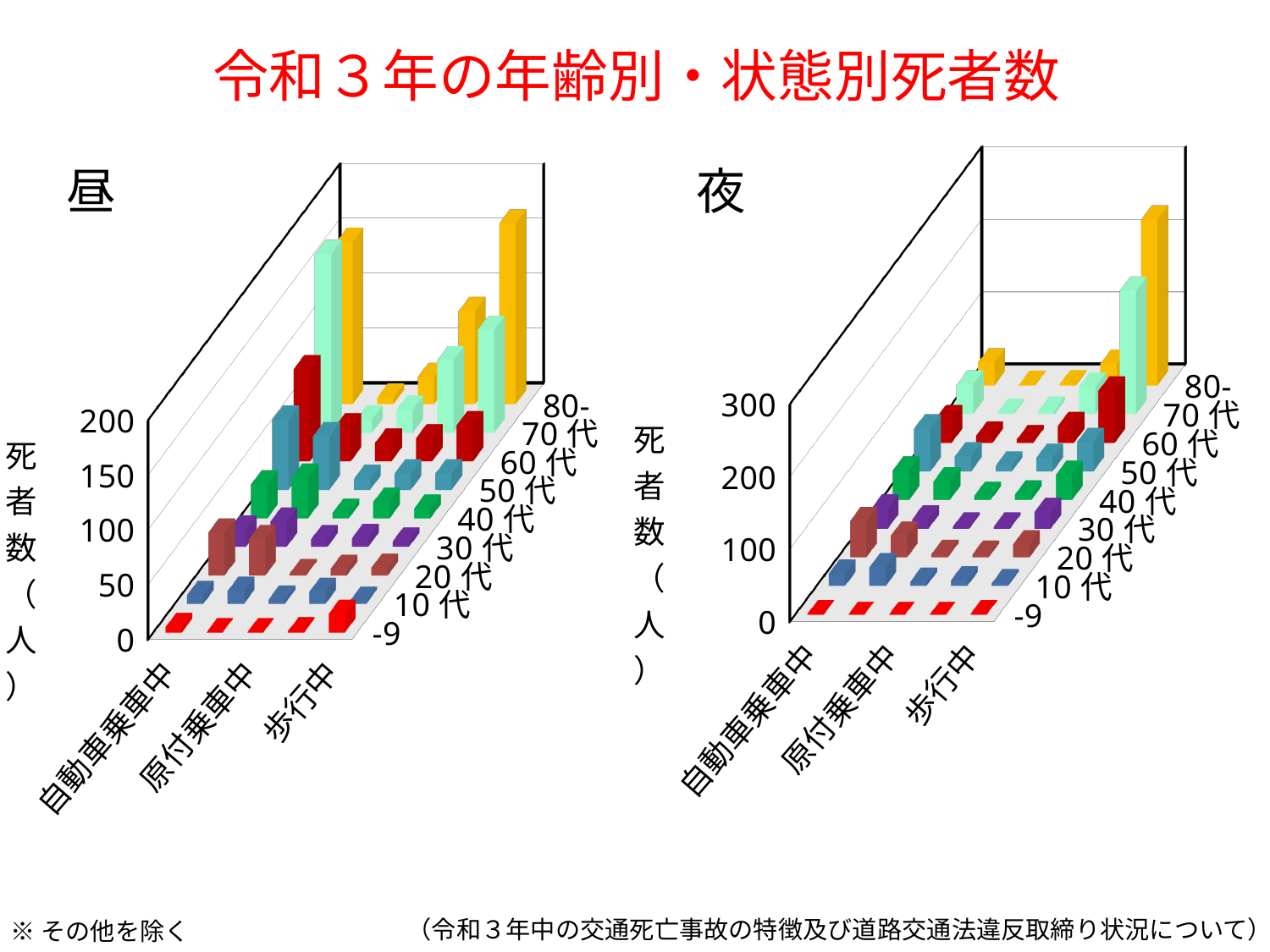
What is the highest value shown on the vertical axis of the 夜 chart? 300 What is the highest value shown on the vertical axis of the 昼 chart? 200 What is the title of the slide containing the two charts? 令和３年の年齢別・状態別死者数 In the 昼 chart, is the value for 歩行中 in the 80- age group greater or less than 100? greater How many age groups are shown along the depth axis of the 昼 chart? 9 In the 昼 chart, which is larger: the value for 歩行中 in the 80- age group or the value for 歩行中 in the 10代 age group? 歩行中 80- In the 夜 chart, is the value for 原付乗車中 in the 30代 age group greater or less than 100? less In the 夜 chart, which category and age group has the tallest bar? 歩行中, 80- How many categories are shown along the front axis of the 夜 chart? 5 In the 昼 chart, is the value for 自動車乗車中 in the -9 age group greater or less than 50? less What kind of chart is the 昼 chart? bar chart